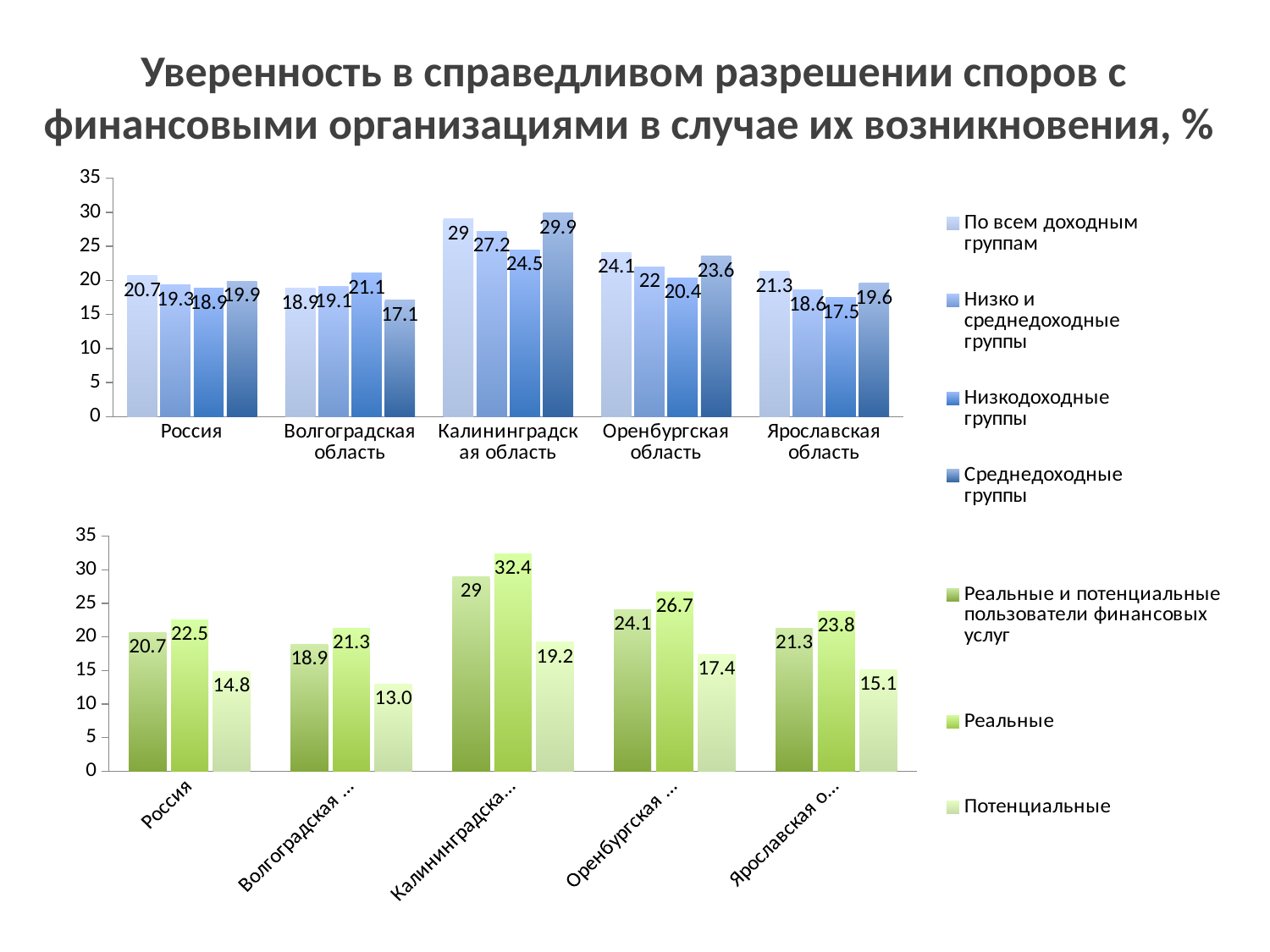
In the top chart, which region has the lowest value in the series 'Среднедоходные группы'? Волгоградская область In the top chart, which region has the highest value in the series 'По всем доходным группам'? Калининградская область In the top chart, what is the value for Волгоградская область in the series 'Низкодоходные группы'? 21.1 In the top chart, what is the difference between the 'По всем доходным группам' values for Оренбургская область and Ярославская область? 2.8 In the bottom chart, which series has the lowest value for Россия? Потенциальные In the bottom chart, what is the value for Россия in the series 'Реальные'? 22.5 In the bottom chart, is the value for Россия in the series 'Реальные' greater or less than 20? greater In the top chart, what is the value for Калининградская область in the series 'Среднедоходные группы'? 29.9 In the bottom chart, what is the value for Россия in the series 'Потенциальные'? 14.8 What type of chart is the bottom chart? Bar chart How many series does the legend of the top chart list? 4 In the top chart, what is the value for Россия in the series 'По всем доходным группам'? 20.7